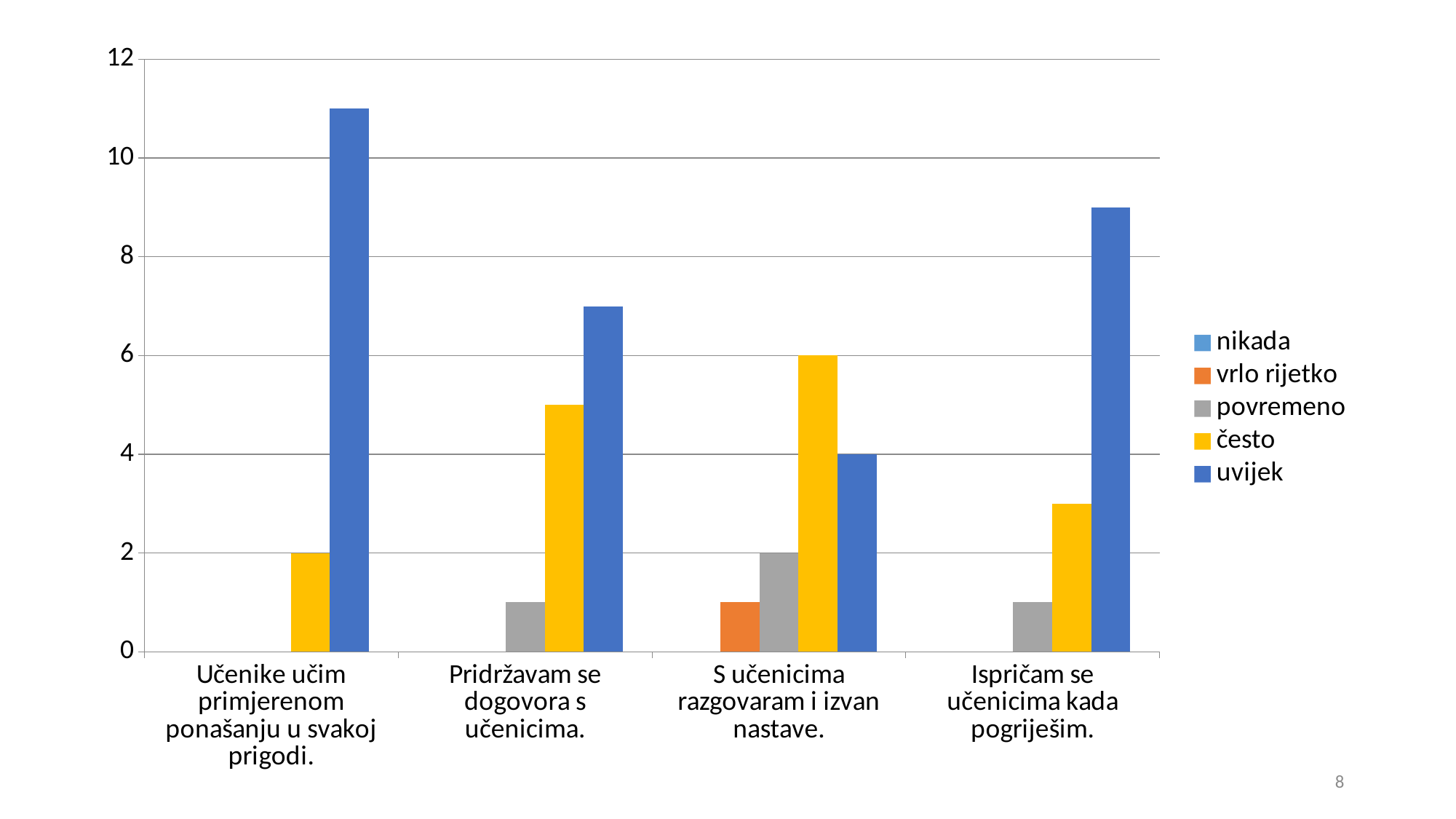
Which category has the highest "uvijek" value? Učenike učim primjerenom ponašanju u svakoj prigodi. Which series is shown in yellow in the legend? često How many categories are shown on the x axis? 4 How many series does the legend list? 5 Is the value of "uvijek" for "Učenike učim primjerenom ponašanju u svakoj prigodi." greater or less than 10? greater For "S učenicima razgovaram i izvan nastave.", which is larger: "često" or "uvijek"? često Is the value of "uvijek" for "Ispričam se učenicima kada pogriješim." greater or less than 8? greater What is the value of "uvijek" for "S učenicima razgovaram i izvan nastave."? 4 What kind of chart is shown on the slide? bar chart What is the value of "povremeno" for "S učenicima razgovaram i izvan nastave."? 2 What is the value of "često" for "Učenike učim primjerenom ponašanju u svakoj prigodi."? 2 What is the value of "često" for "S učenicima razgovaram i izvan nastave."? 6